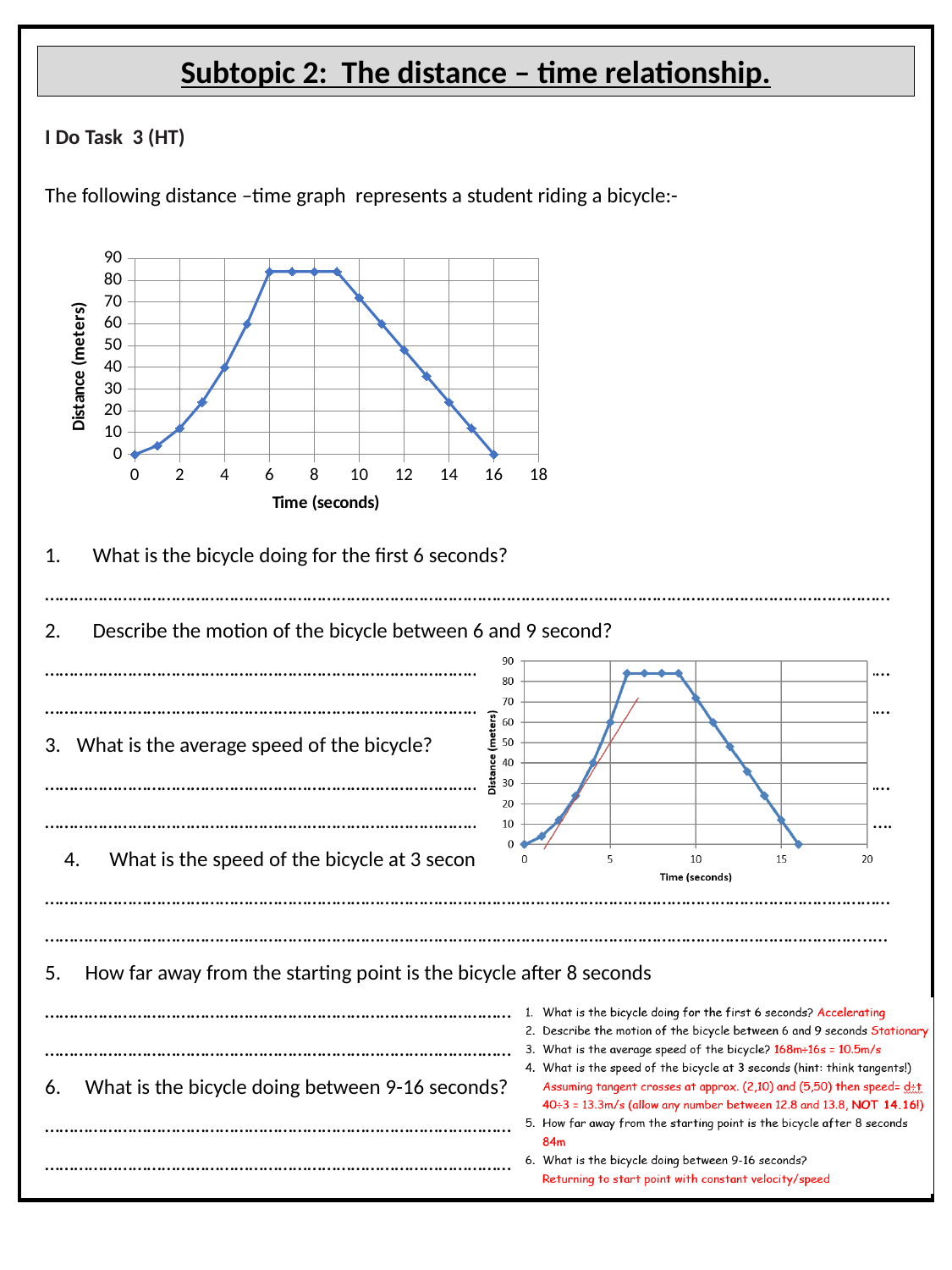
On the top chart, what is the title of the x axis? Time (seconds) What kind of chart is the main distance-time graph at the top of the slide? line chart On the top chart, is the distance at 2 seconds greater or less than 20? less On the top chart, does the distance rise or fall between 9 and 16 seconds? fall On the top chart, what is the title of the y axis? Distance (meters) On the top chart, what is the distance at 5 seconds? 60 On the top chart, what is the distance at 4 seconds? 40 On the top chart, how many data points are plotted? 17 On the top chart, which is larger: the distance at 3 seconds or the distance at 13 seconds? 13 seconds On the top chart, is the distance at 14 seconds greater or less than 30? less On the top chart, what is the distance at 16 seconds? 0 On the top chart, is the distance at 8 seconds greater or less than 80? greater